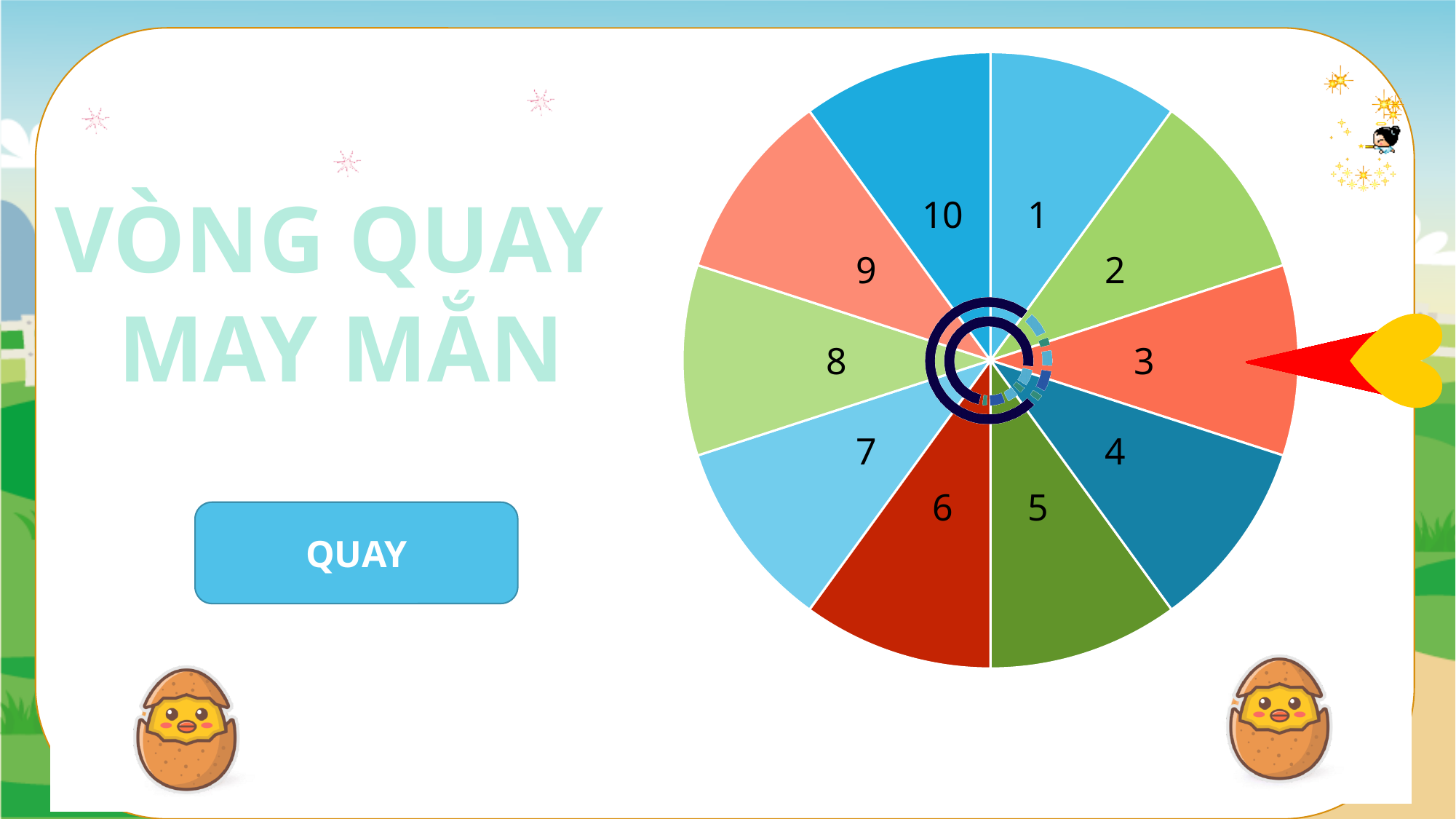
What is the highest number labelled on a slice of the wheel? 10 What is the title shown on the left of the slide? VÒNG QUAY MAY MẮN How many slices does the wheel on the slide have? 10 What is the lowest number labelled on a slice of the wheel? 1 Which slice number does the red pointer on the right of the wheel point to? 3 What kind of chart is used for the wheel on the slide? pie chart